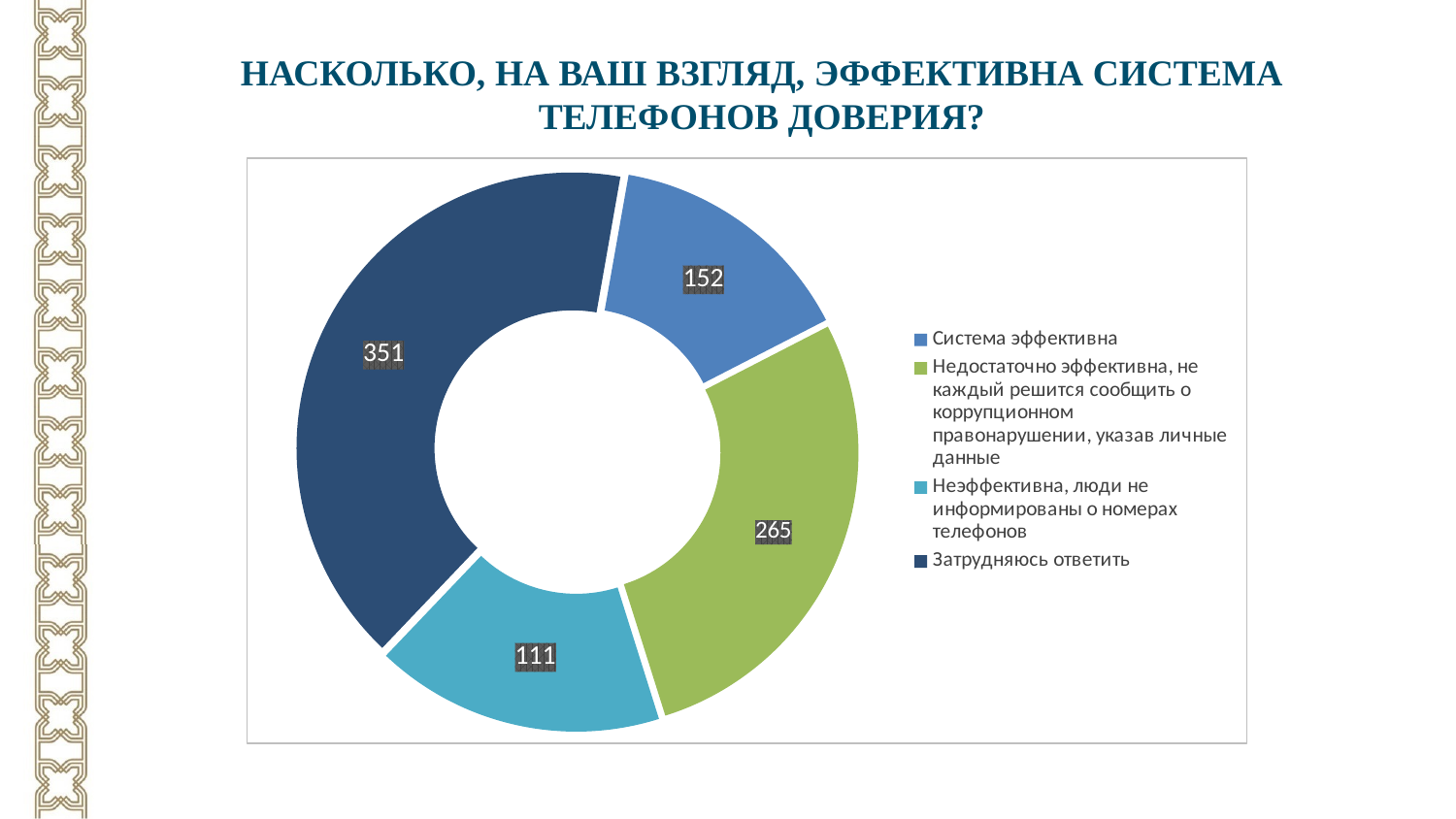
What is the total of all four values in the chart? 879 How many categories does the chart show? 4 Which category has the highest value? Затрудняюсь ответить What is the value for "Затрудняюсь ответить"? 351 What is the value for "Система эффективна"? 152 What is the difference between the values for "Затрудняюсь ответить" and "Система эффективна"? 199 What type of chart is shown on the slide? Doughnut (pie) chart What is the value for "Недостаточно эффективна, не каждый решится сообщить о коррупционном правонарушении, указав личные данные"? 265 Which is larger: the value for "Недостаточно эффективна..." or the value for "Система эффективна"? Недостаточно эффективна... What colour is the slice for "Затрудняюсь ответить"? Dark blue What is the value for "Неэффективна, люди не информированы о номерах телефонов"? 111